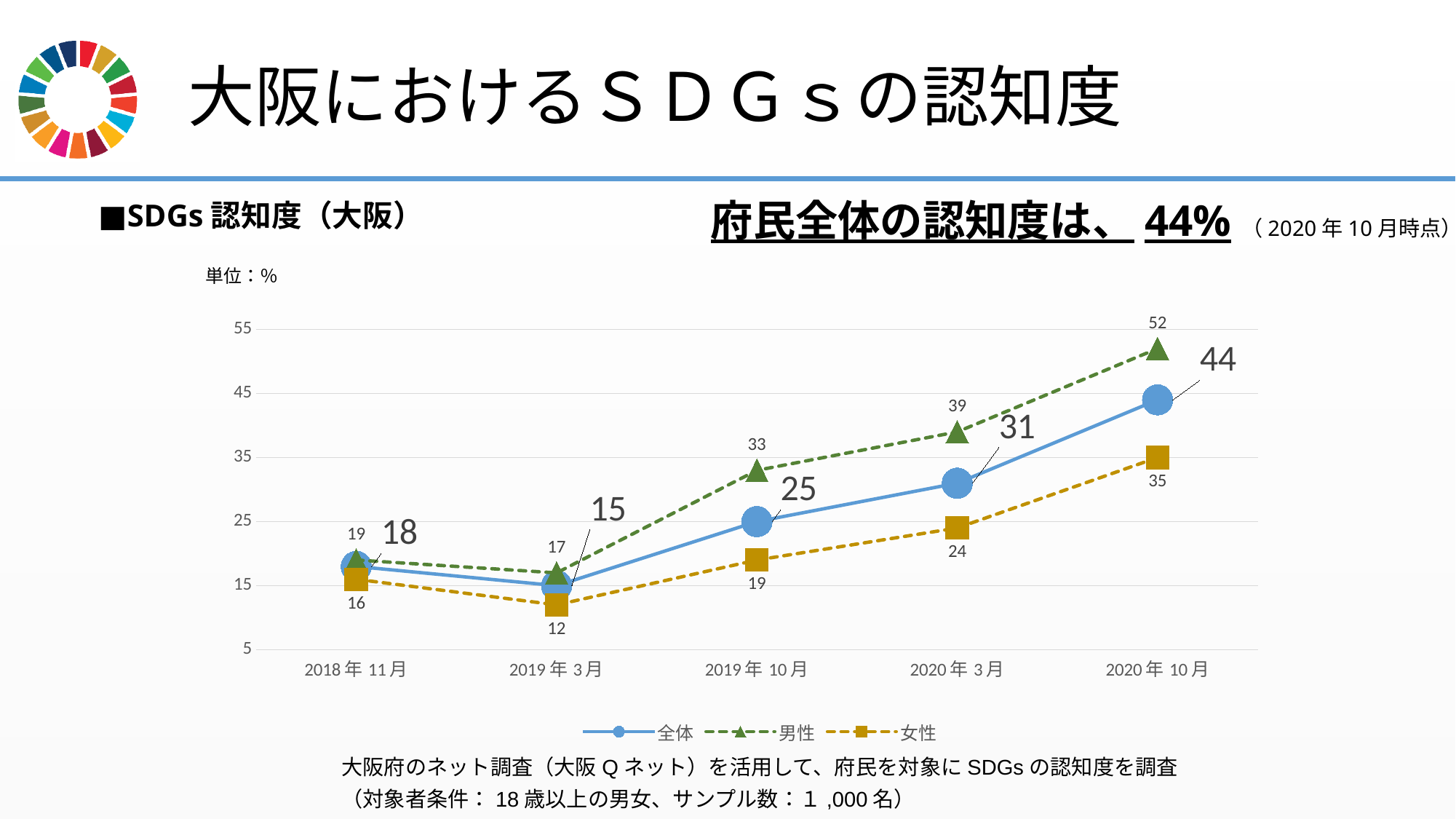
What is the value for 男性 in 2019年10月? 33 At which time point is the 全体 series lowest? 2019年3月 Which is larger in 2020年3月, the 男性 value or the 女性 value? 男性 What kind of chart is shown on the slide? line chart How many series does the legend list? 3 What is the value for 全体 in 2020年10月? 44 What is the difference between the 男性 and 女性 values in 2020年10月? 17 Does the 全体 series rise or fall from 2019年3月 to 2020年10月? rise At which time point is the 男性 series highest? 2020年10月 Is the value for 女性 in 2020年10月 greater or less than 25? greater What is the value for 女性 in 2019年3月? 12 How many time points are shown on the x axis? 5